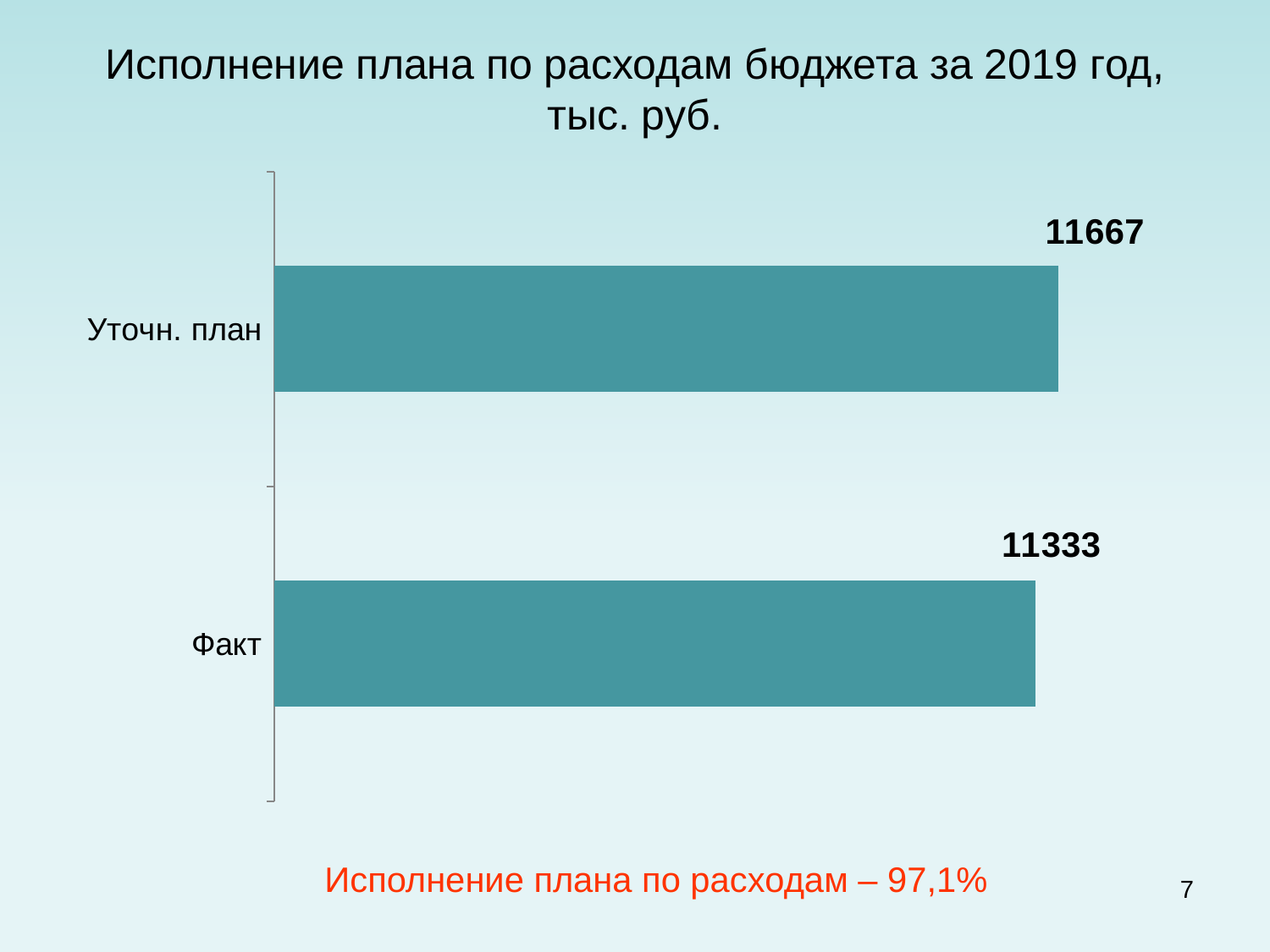
Which category has the lowest value? Факт Which category has the highest value? Уточн. план What is the title of the slide? Исполнение плана по расходам бюджета за 2019 год, тыс. руб. What is the difference between the values for Уточн. план and Факт? 334 How many categories are shown in the chart? 2 What is the value for Уточн. план? 11667 What is the value for Факт? 11333 What percentage of plan execution for expenses is stated below the chart? 97,1% Which is larger, the value for Уточн. план or the value for Факт? Уточн. план What kind of chart is shown on the slide? bar chart